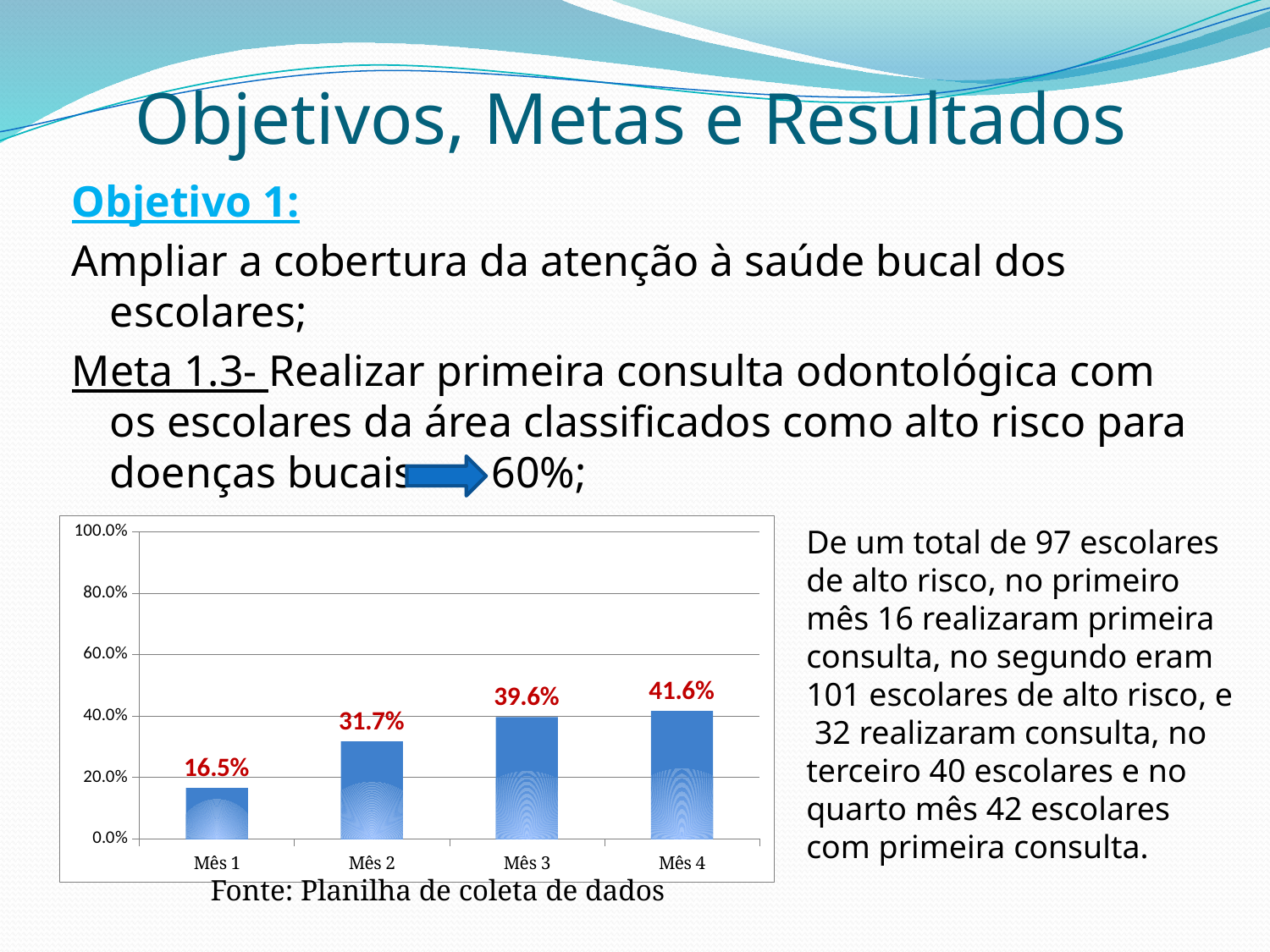
What is the difference between the values for Mês 4 and Mês 1? 25.1% Which month has the lowest value? Mês 1 What is the difference between the values for Mês 2 and Mês 1? 15.2% Which is larger, the value for Mês 2 or the value for Mês 3? Mês 3 What is the value for Mês 2? 31.7% What is the value for Mês 4? 41.6% Is the value for Mês 4 greater or less than 60.0%? less What is the value for Mês 3? 39.6% How many months are shown on the x axis? 4 Which month has the highest value? Mês 4 What is the value for Mês 1? 16.5% What kind of chart is shown on the slide? bar chart